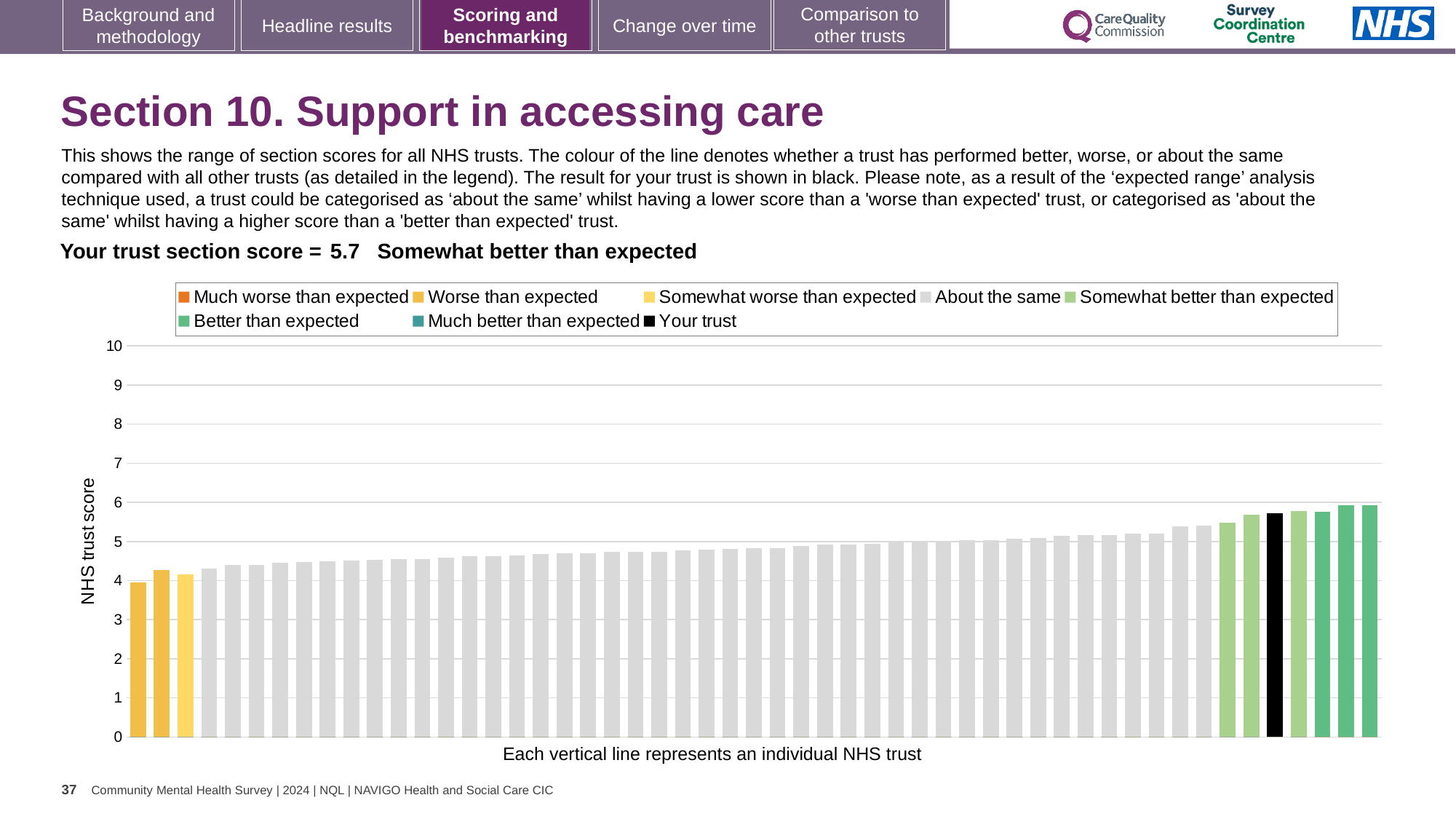
How many bars are coloured as 'Better than expected' (dark green)? 3 How many entries does the chart legend list? 8 What is the label on the vertical axis of the chart? NHS trust score How many bars are coloured as 'Worse than expected' (yellow)? 2 What kind of chart is shown on the slide? bar chart What colour is used for the 'Your trust' bar in the chart? black Do the bar values rise or fall from left to right along the x axis? rise Is the value for your trust (the black bar) greater or less than 5? greater Which category is your trust placed in for this section? Somewhat better than expected Is the value of the leftmost bar greater or less than 5? less Which is larger, the leftmost bar or the rightmost bar? the rightmost bar What is your trust's section score as printed on the slide? 5.7